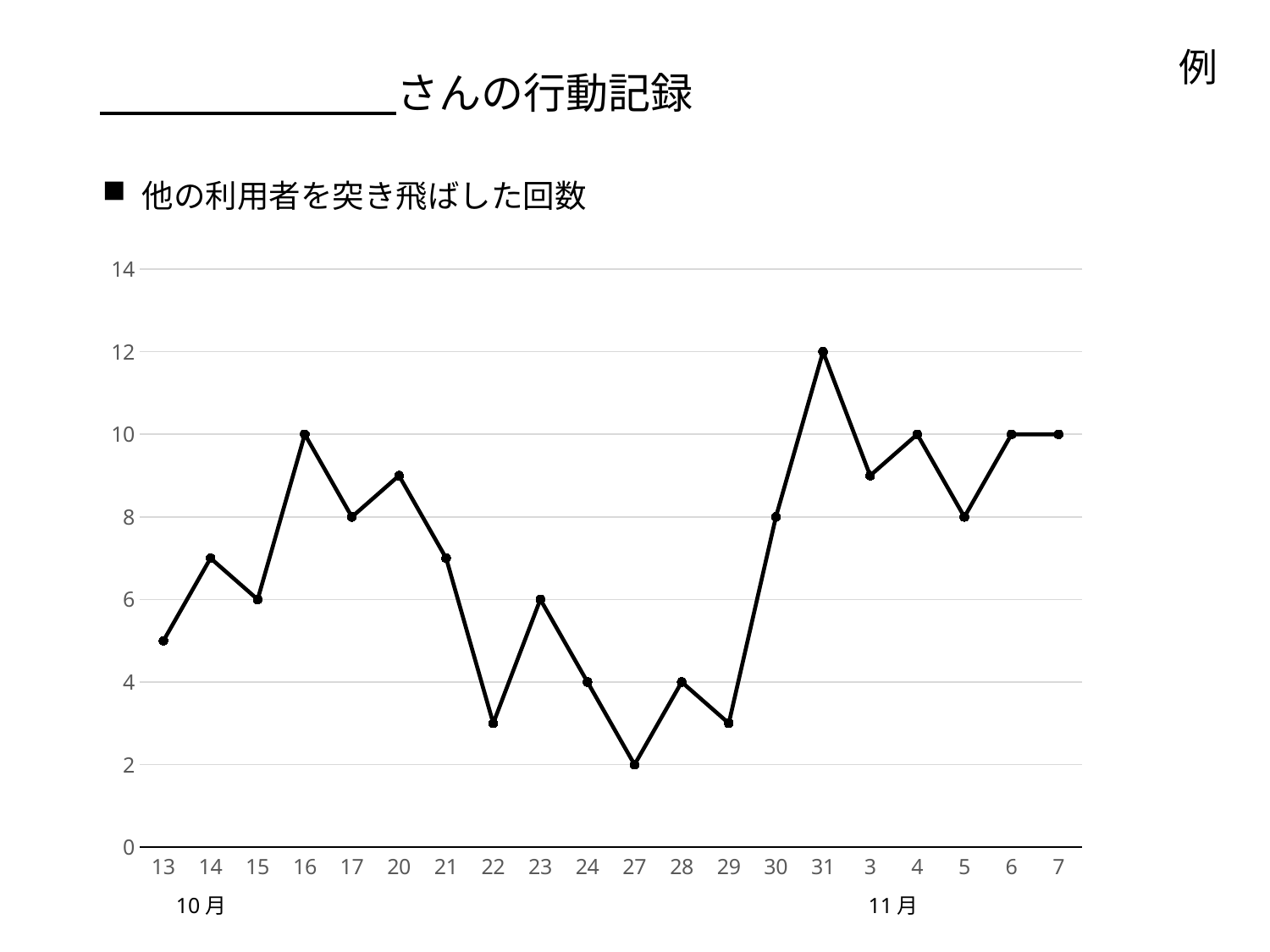
Do the values rise or fall from 10月29日 to 10月31日? rise Which is larger, the value for 10月16日 or the value for 10月22日? 10月16日 What is the difference between the values for 10月31日 and 10月27日? 10 What kind of chart is shown on the slide? line chart On which date is the number of times pushing other users lowest? 10月27日 What is the value for 10月27日? 2 Is the value for 10月13日 greater or less than 4? greater On which date is the number of times pushing other users highest? 10月31日 What is the value for 10月16日? 10 How many data points are plotted on the chart? 20 What is the value for 10月31日? 12 What is the value for 11月5日? 8